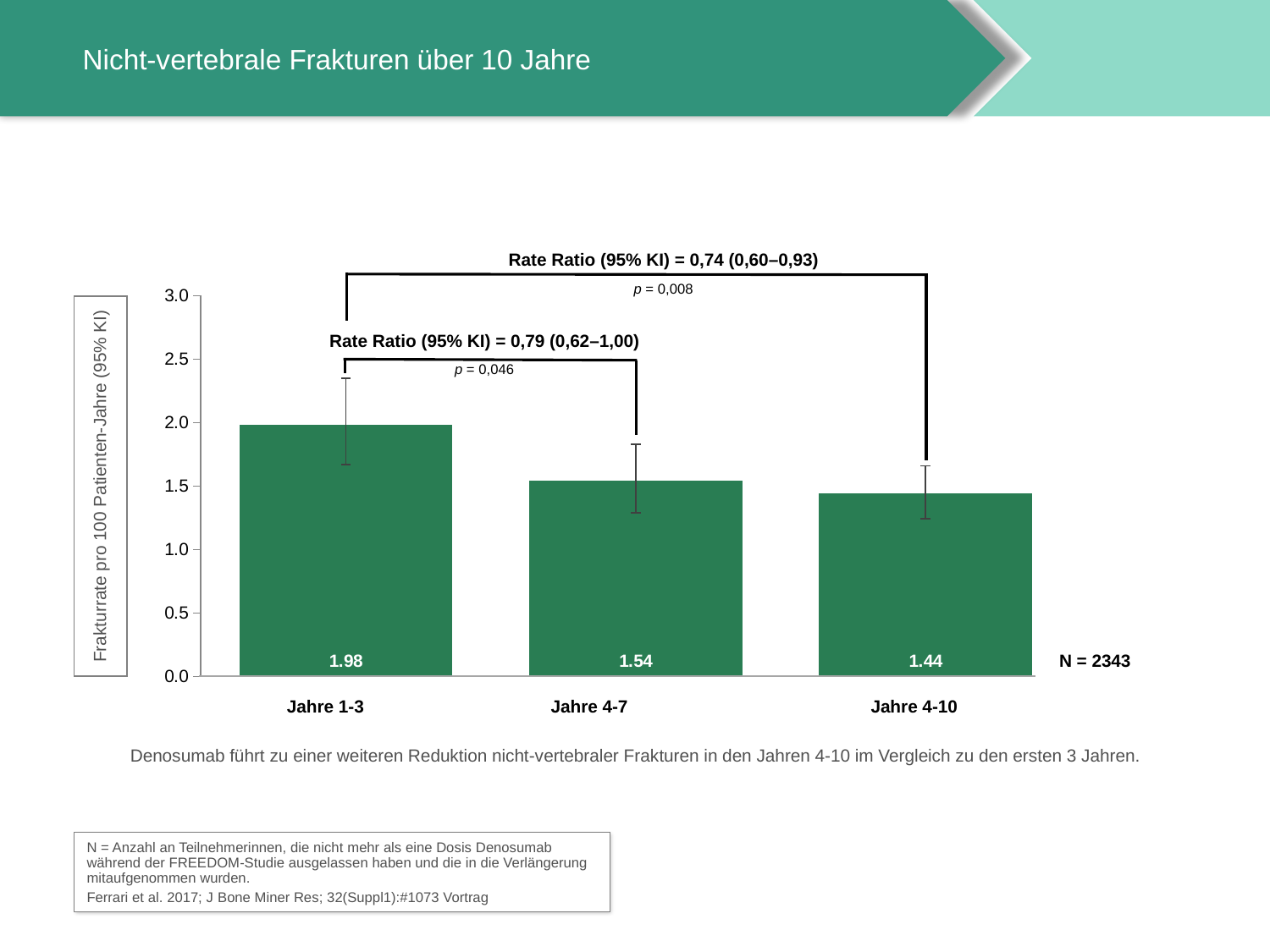
What is the difference between the fracture rates for Jahre 1-3 and Jahre 4-7? 0.44 Which period has the lowest fracture rate? Jahre 4-10 What is the fracture rate for Jahre 4-7? 1.54 Do the fracture rates rise or fall from Jahre 1-3 to Jahre 4-10? fall What is the fracture rate for Jahre 4-10? 1.44 How many periods are shown on the x axis? 3 Which period has the highest fracture rate? Jahre 1-3 Is the value for Jahre 4-10 greater or less than 1.5? less What is the fracture rate for Jahre 1-3? 1.98 Which is larger, the fracture rate for Jahre 4-7 or for Jahre 4-10? Jahre 4-7 What is the difference between the fracture rates for Jahre 1-3 and Jahre 4-10? 0.54 What kind of chart is shown on the slide? bar chart